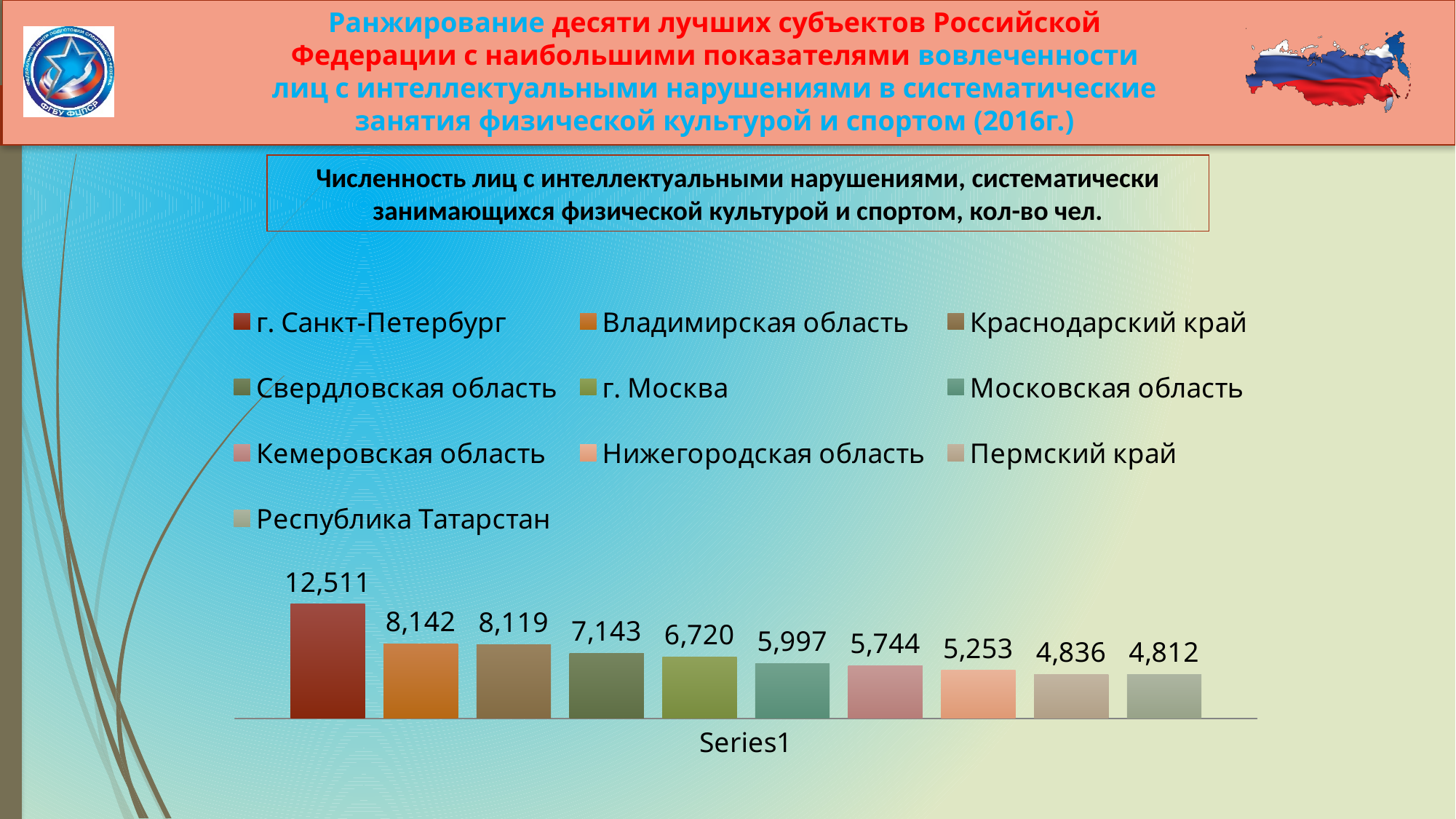
How many bars are plotted in the chart? 10 What is the difference between the values for Свердловская область and г. Москва? 423 What is the value for г. Москва? 6,720 Which region has the lowest value? Республика Татарстан Which region has the highest value? г. Санкт-Петербург Which is larger, the value for Московская область or the value for Кемеровская область? Московская область What is the value for Пермский край? 4,836 How many entries does the legend list? 10 What is the value for г. Санкт-Петербург? 12,511 What is the difference between the values for г. Санкт-Петербург and Владимирская область? 4,369 What kind of chart is shown on the slide? Bar chart Do the bar values rise or fall from left to right? Fall